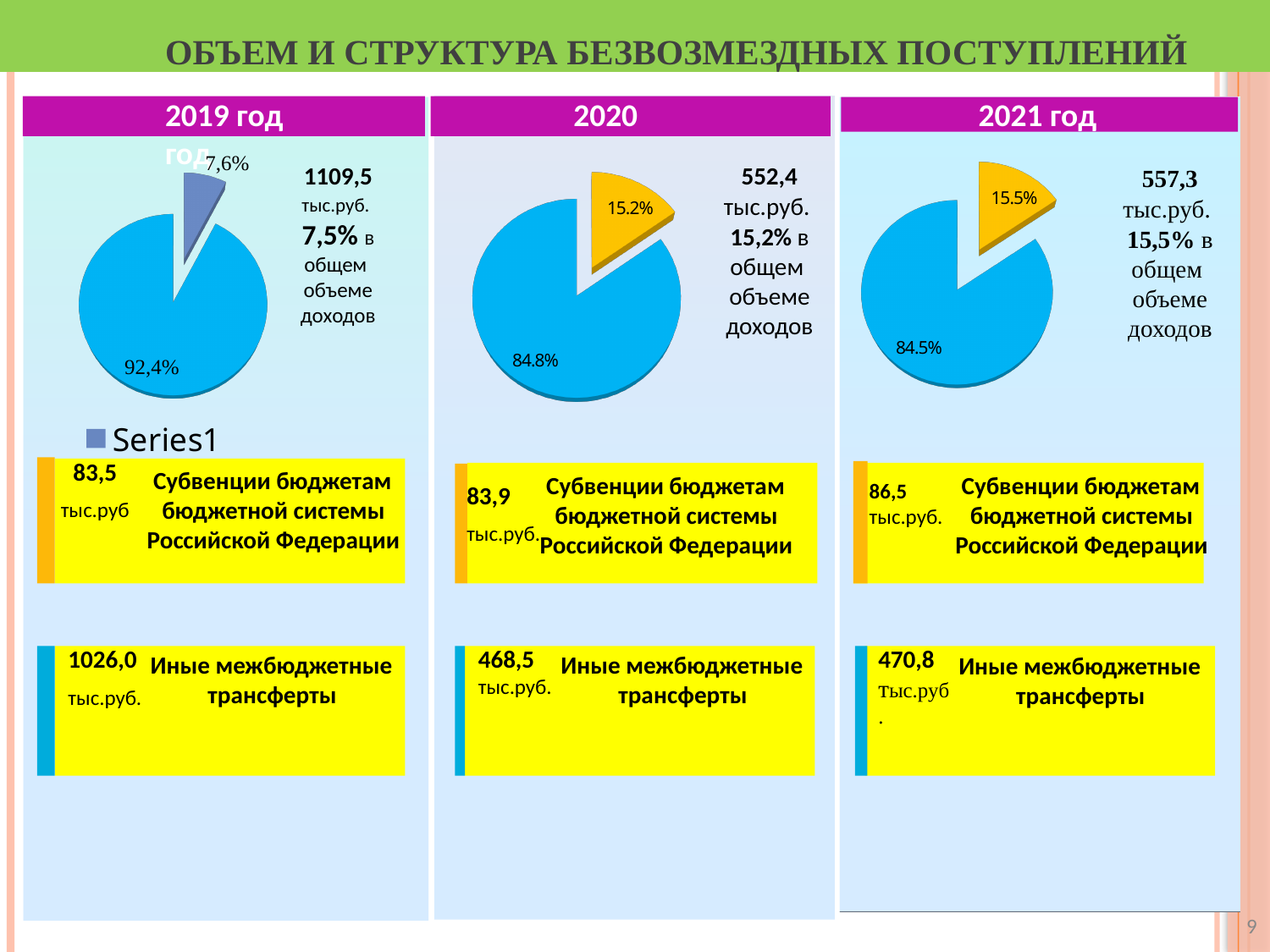
In the 2019 год pie chart, what colour is the larger slice? blue In the 2021 год pie chart, what percentage is shown on the smaller (yellow) slice? 15.5% Which pie chart has the larger small (yellow) slice: the 2020 год chart or the 2021 год chart? 2021 год In the 2021 год pie chart, what percentage is shown on the larger (blue) slice? 84.5% What kind of chart is shown under the 2019 год heading? pie chart In the 2021 год pie chart, what is the difference between the larger slice and the smaller slice in percentage points? 69 In the 2019 год pie chart, what percentage is shown on the larger slice? 92,4% What legend entry is shown below the 2019 год pie chart? Series1 In the 2020 год pie chart, what percentage is shown on the smaller (yellow) slice? 15.2% How many slices does the 2020 год pie chart have? 2 In the 2020 год pie chart, what percentage is shown on the larger (blue) slice? 84.8% In the 2019 год pie chart, what percentage is shown on the smaller slice? 7,6%